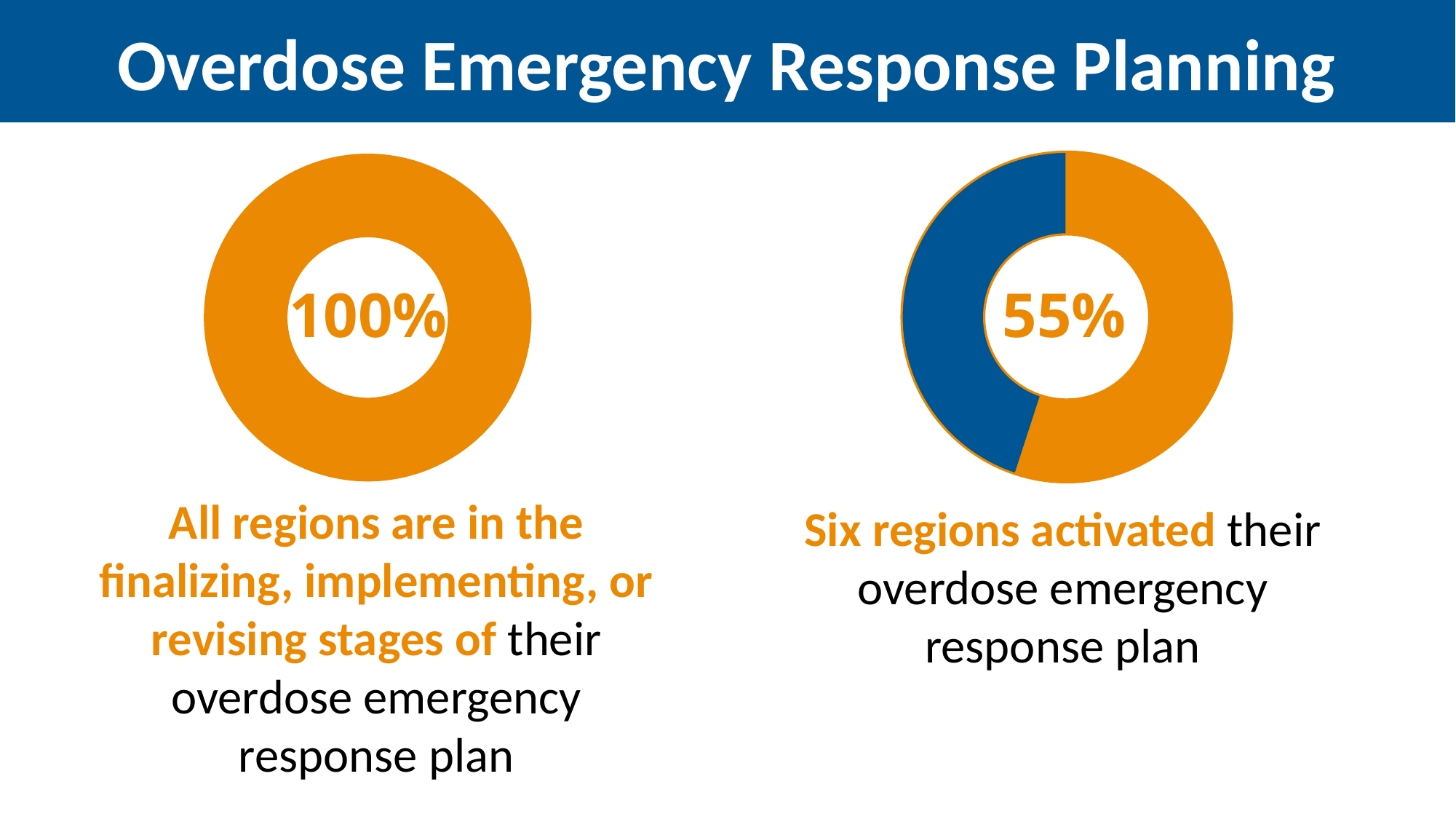
How many segments does the left chart have? 1 In the right chart, which segment is larger, the orange one or the blue one? The orange one Which chart shows the larger percentage, the left one or the right one? The left one (100%) What is the difference between the percentage on the left chart and the percentage on the right chart? 45% In the right chart, what share of the ring does the blue segment represent? 45% According to the caption under the right chart, what does the 55% represent? Six regions activated their overdose emergency response plan What percentage is shown in the centre of the right chart? 55% What percentage is shown in the centre of the left chart? 100% What kind of chart is shown on the left side of the slide? Donut (pie) chart How many segments does the right chart have? 2 What is the title of the slide containing the two donut charts? Overdose Emergency Response Planning In the right chart, is the orange portion greater or less than 50%? greater